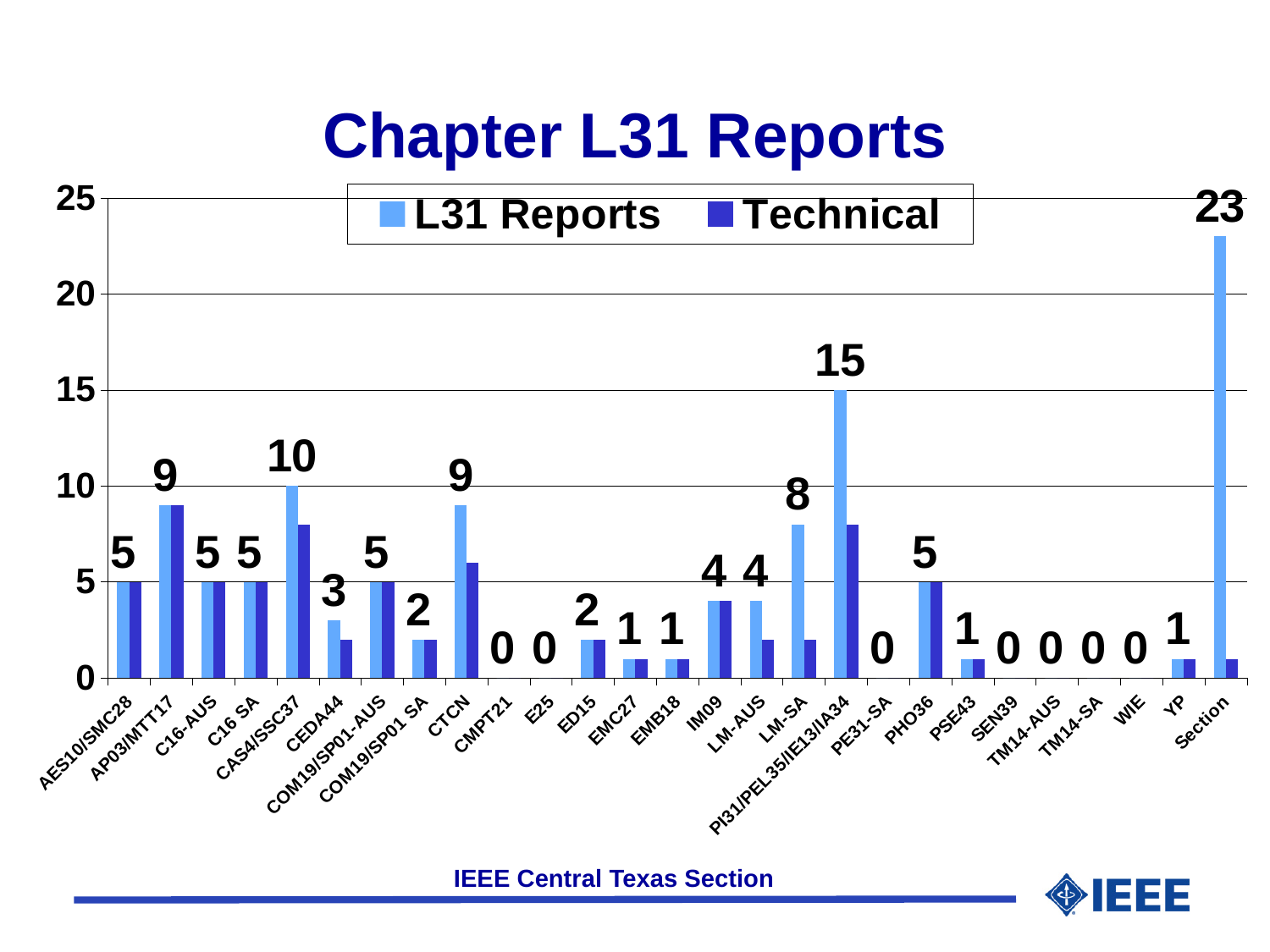
What kind of chart is shown on the slide? bar chart How many categories are shown on the x axis? 27 How many series does the legend list? 2 Is the Technical value for Section greater or less than 5? less What is the L31 Reports value for PI31/PEL35/IE13/IA34? 15 What are the two series named in the legend? L31 Reports and Technical What is the L31 Reports value for CEDA44? 3 Is the Technical value for PI31/PEL35/IE13/IA34 greater or less than 5? greater Which category has the highest L31 Reports value? Section What is the L31 Reports value for Section? 23 What is the difference between the L31 Reports values for Section and PI31/PEL35/IE13/IA34? 8 Which has a larger L31 Reports value, CAS4/SSC37 or CTCN? CAS4/SSC37